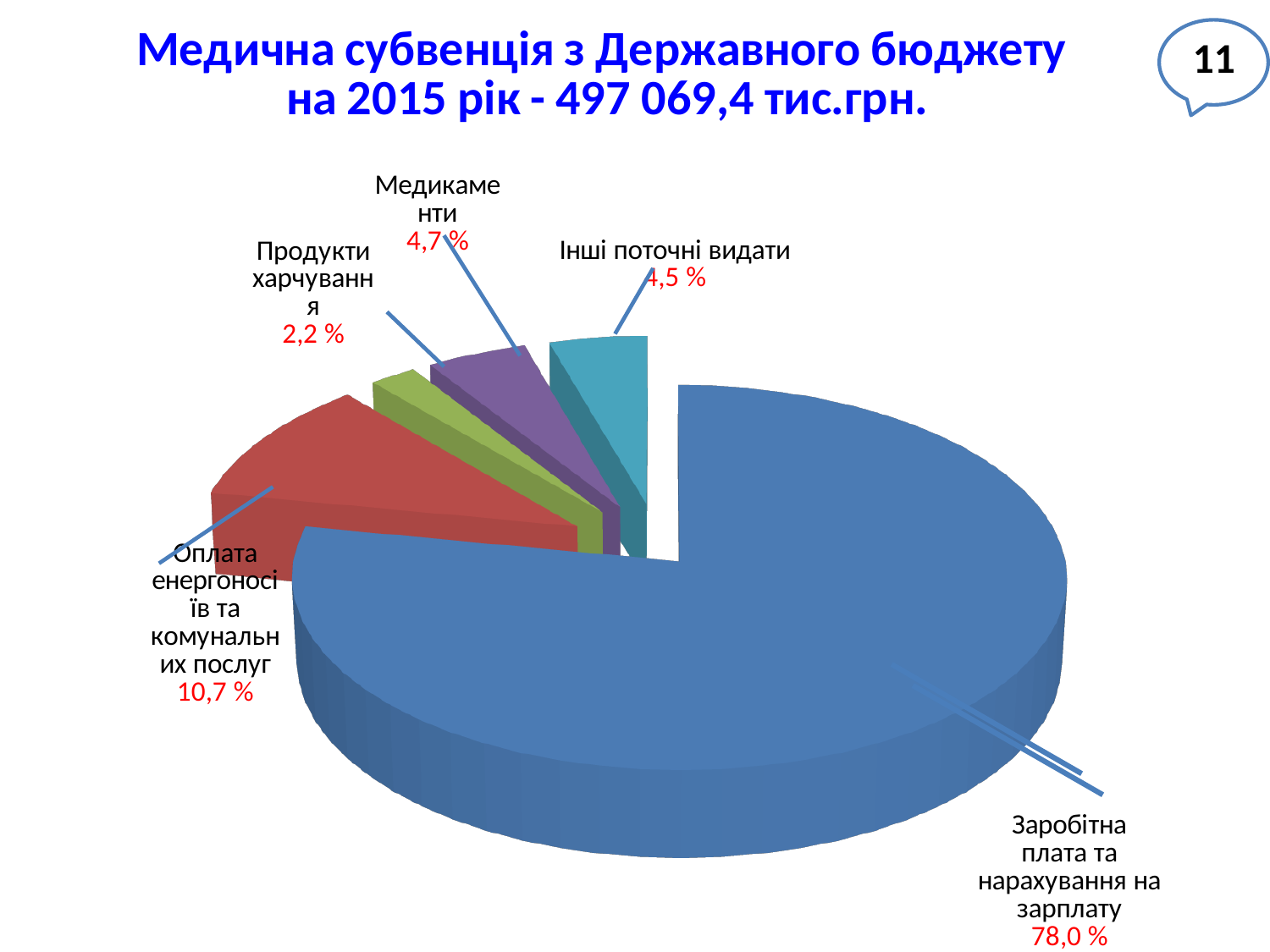
What kind of chart is shown on the slide? Pie chart Which category has the largest slice of the pie? Заробітна плата та нарахування на зарплату What is the value shown for Медикаменти? 4,7 % Which category has the smallest slice of the pie? Продукти харчування What is the value shown for Оплата енергоносіїв та комунальних послуг? 10,7 % What is the difference between the shares of Оплата енергоносіїв та комунальних послуг and Медикаменти? 6,0 % How many slices does the pie chart have? 5 What is the value shown for Інші поточні видати? 4,5 % What share of the pie does Заробітна плата та нарахування на зарплату take? 78,0 % What is the value shown for Продукти харчування? 2,2 % What total amount is stated in the slide title for the medical subvention in 2015? 497 069,4 тис.грн. Which is larger: the share for Оплата енергоносіїв та комунальних послуг or the share for Інші поточні видати? Оплата енергоносіїв та комунальних послуг